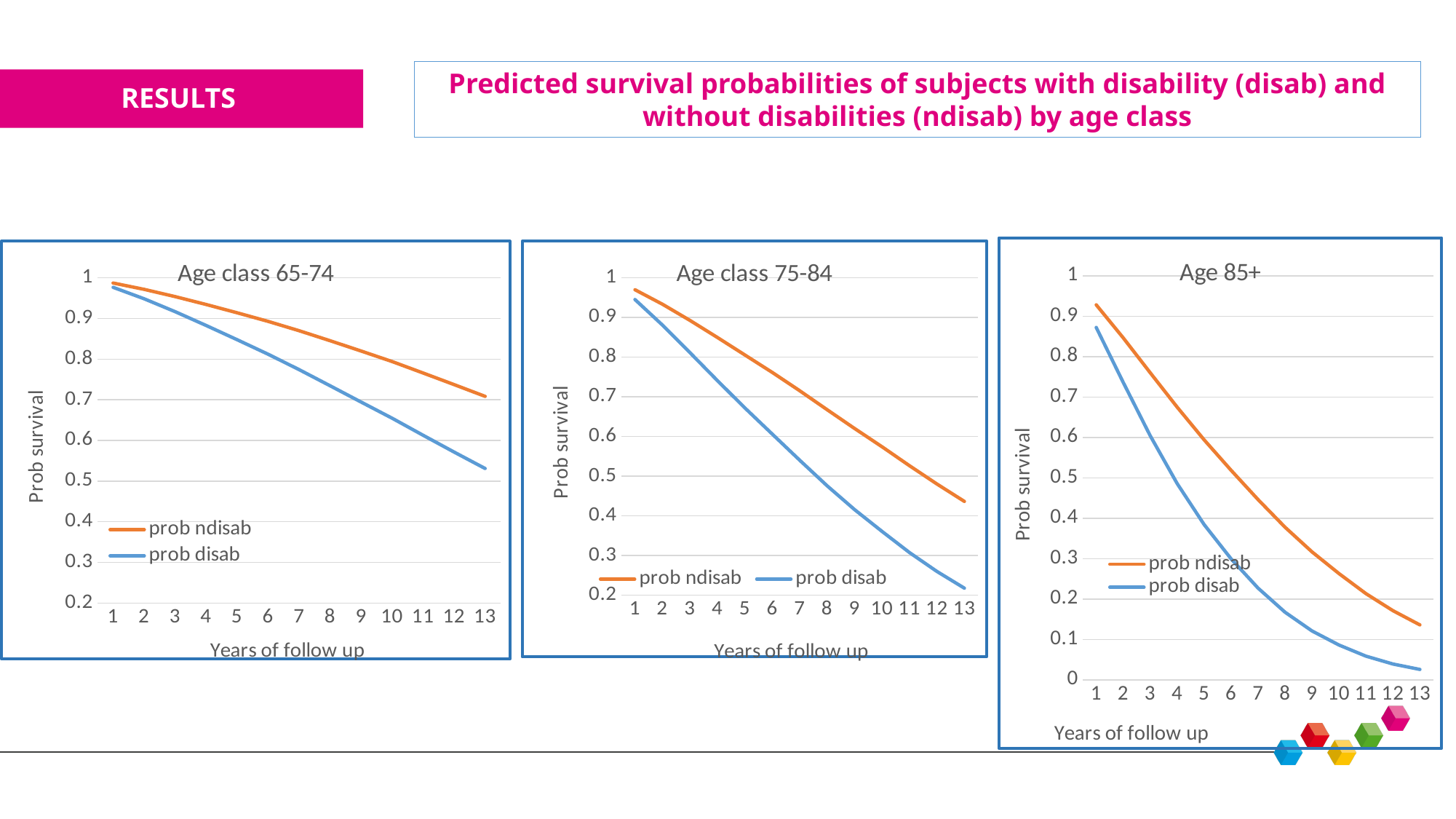
In the 'Age 85+' chart, which series has the higher value at year 13, prob ndisab or prob disab? prob ndisab In the 'Age class 75-84' chart, how many series does the legend list? 2 In the 'Age class 65-74' chart, is the value for prob ndisab at year 13 greater or less than 0.6? greater In the 'Age class 65-74' chart, is the value for prob disab at year 13 greater or less than 0.6? less In the 'Age class 75-84' chart, is the value for prob disab at year 13 greater or less than 0.3? less What is the label of the y axis in the 'Age class 75-84' chart? Prob survival What is the title of the rightmost chart on the slide? Age 85+ In the 'Age 85+' chart, how many years of follow up are shown on the x axis? 13 What kind of chart is the 'Age class 65-74' chart? line chart In the 'Age class 65-74' chart, do the survival probabilities rise or fall as years of follow up increase? fall